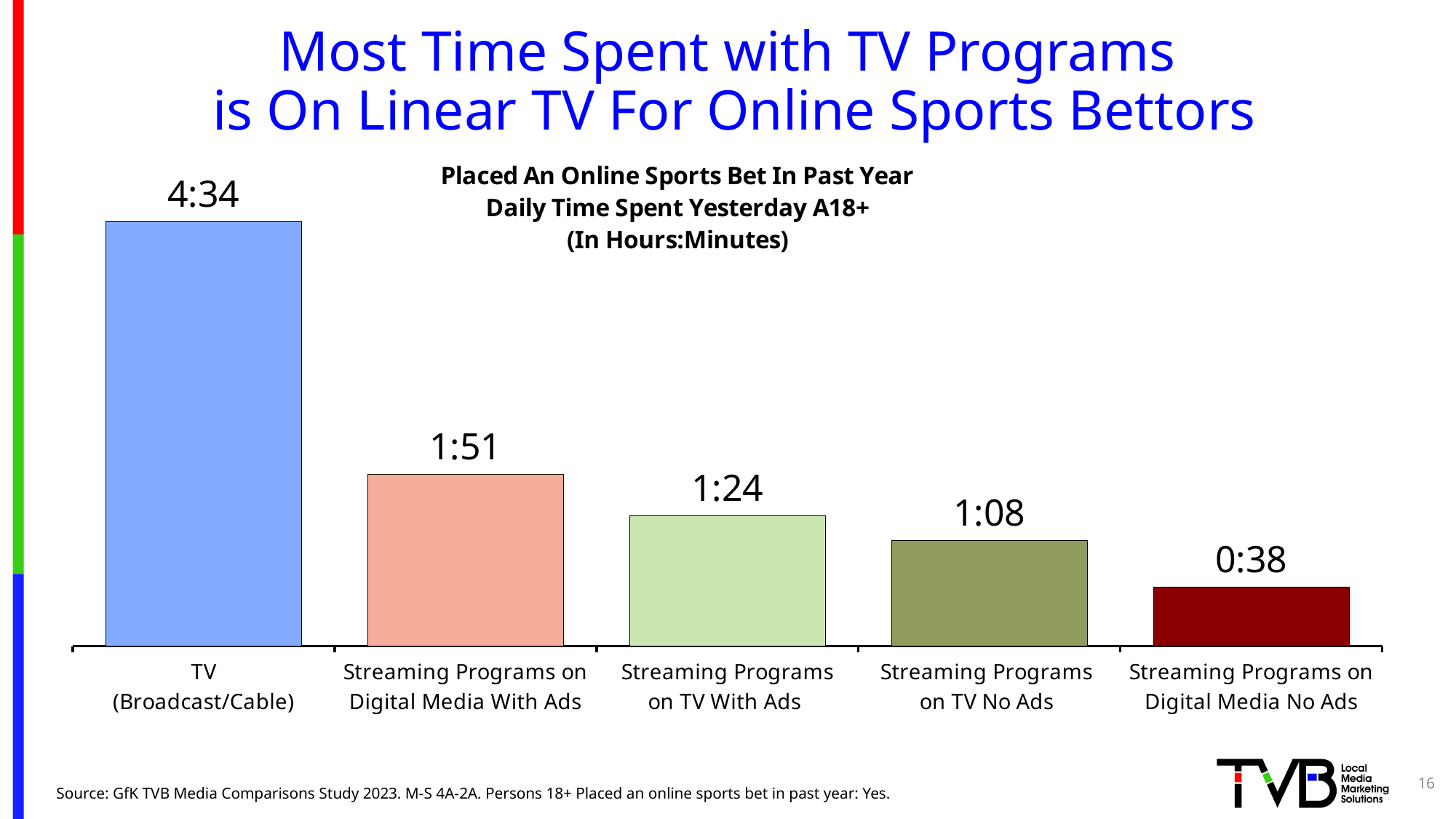
What type of chart is shown on the slide? Bar chart In what units are the values in the chart expressed, according to the chart title? Hours:Minutes What is the daily time spent with Streaming Programs on TV No Ads? 1:08 Which category has the highest daily time spent? TV (Broadcast/Cable) How many categories are shown in the chart? 5 What is the difference in daily time spent between Streaming Programs on TV With Ads and Streaming Programs on TV No Ads? 0:16 What is the daily time spent with Streaming Programs on Digital Media With Ads? 1:51 Which category has the lowest daily time spent? Streaming Programs on Digital Media No Ads Which has more daily time spent: Streaming Programs on TV With Ads or Streaming Programs on Digital Media No Ads? Streaming Programs on TV With Ads How much more daily time is spent with TV (Broadcast/Cable) than with Streaming Programs on Digital Media With Ads? 2:43 What is the daily time spent with TV (Broadcast/Cable)? 4:34 What is the daily time spent with Streaming Programs on Digital Media No Ads? 0:38